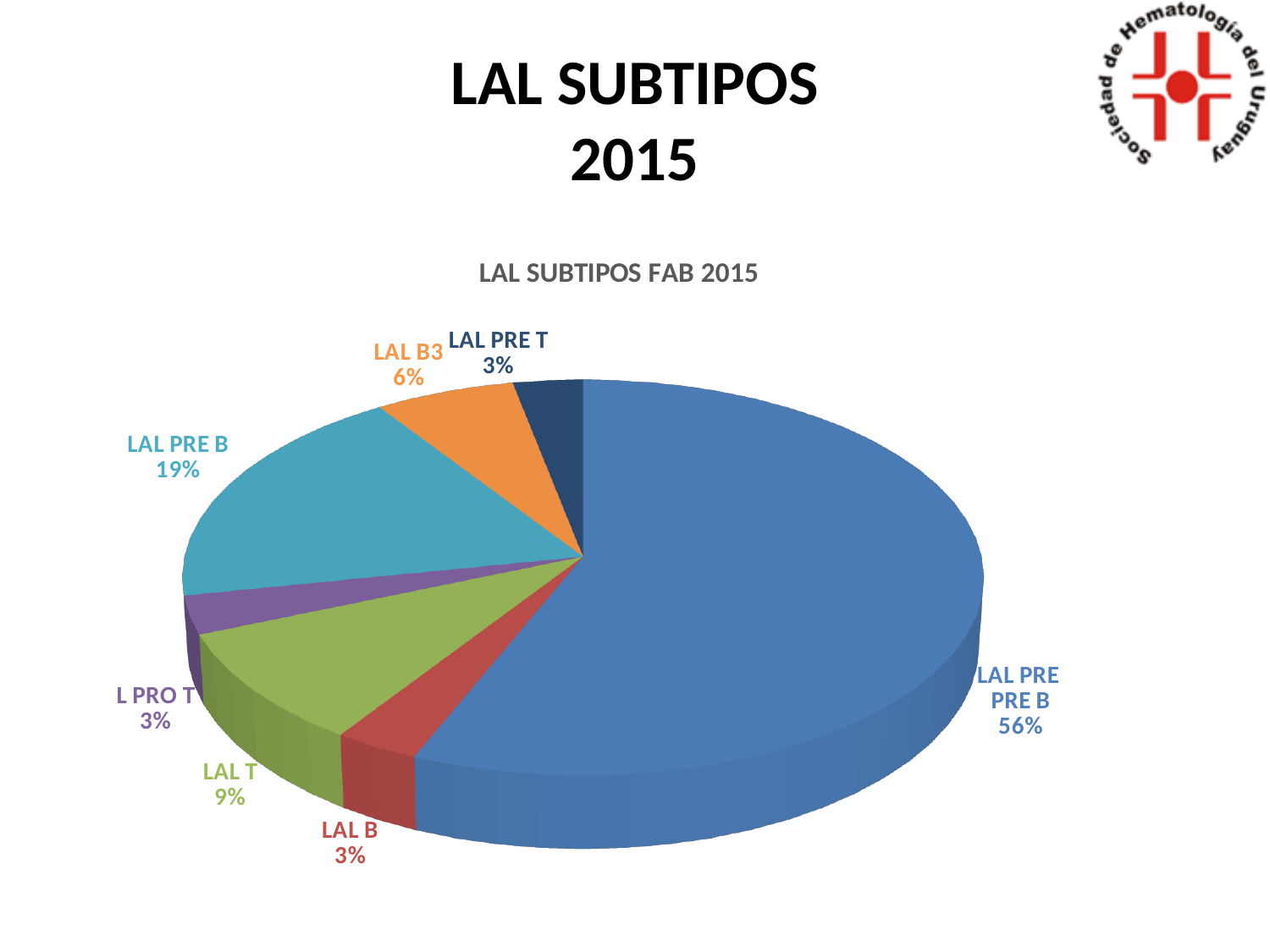
Which subtype has the largest slice of the pie? LAL PRE PRE B What is the value shown for LAL B3? 6% What type of chart is shown on the slide? pie chart How many slices does the pie chart have? 7 What is the difference between the shares of LAL PRE PRE B and LAL PRE B? 37% What is the difference between the shares of LAL PRE B and LAL T? 10% What is the value shown for LAL B? 3% What is the chart's title? LAL SUBTIPOS FAB 2015 Which is larger, the share for LAL T or the share for LAL B3? LAL T What share of the pie does LAL PRE PRE B represent? 56% What share of the pie does LAL PRE B represent? 19% What is the value shown for LAL T? 9%